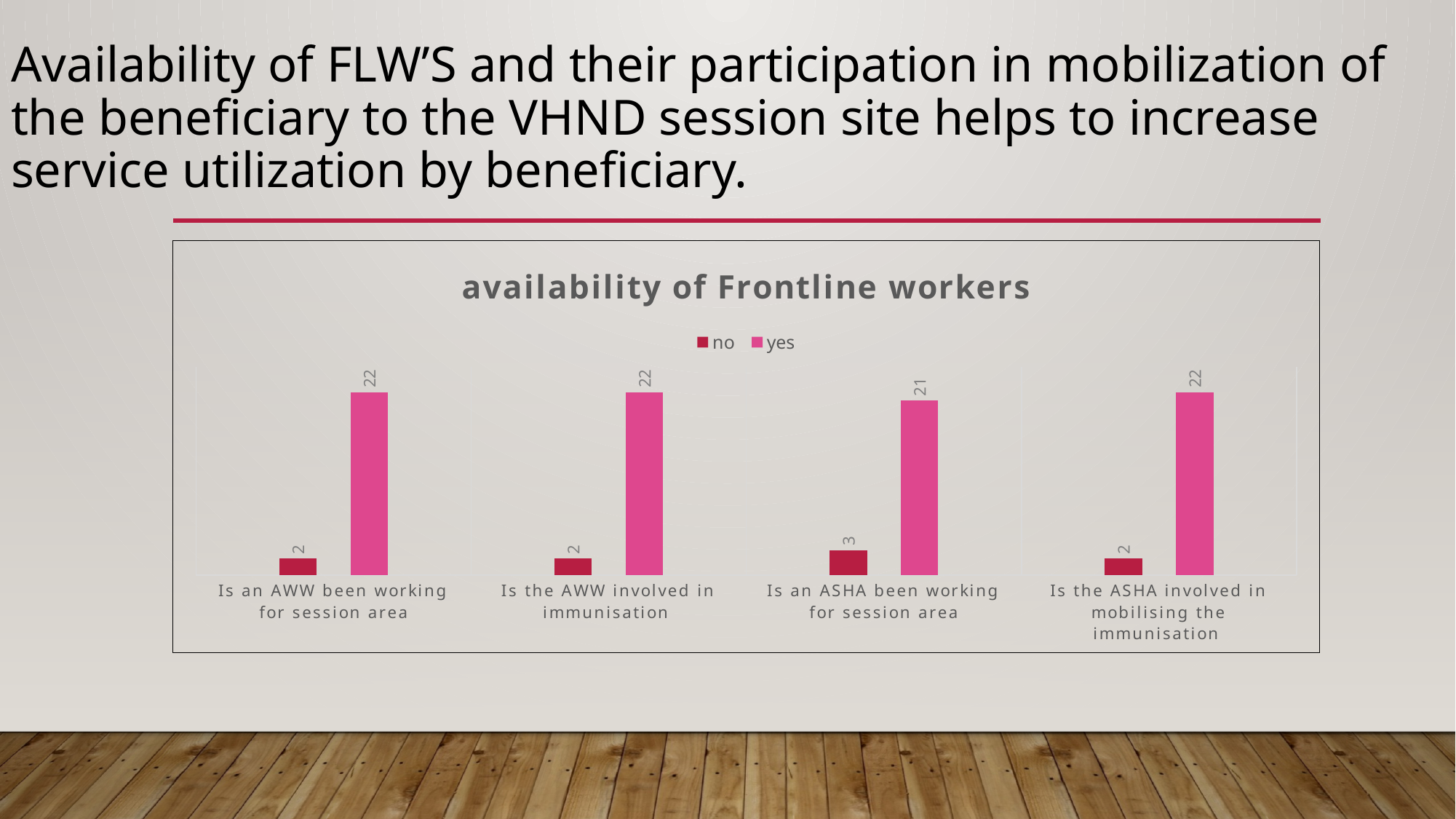
What is the 'yes' value for 'Is an AWW been working for session area'? 22 Which category has the highest 'no' value? Is an ASHA been working for session area What is the 'yes' value for 'Is an ASHA been working for session area'? 21 How many categories are shown on the x axis? 4 What is the 'no' value for 'Is an ASHA been working for session area'? 3 What is the difference between the 'yes' and 'no' values for 'Is the ASHA involved in mobilising the immunisation'? 20 What is the title of the chart? availability of Frontline workers What is the 'no' value for 'Is the AWW involved in immunisation'? 2 Which category has the lowest 'yes' value? Is an ASHA been working for session area How many series does the legend list? 2 What kind of chart is shown on the slide? bar chart Which is larger for 'Is the AWW involved in immunisation': the 'yes' value or the 'no' value? yes